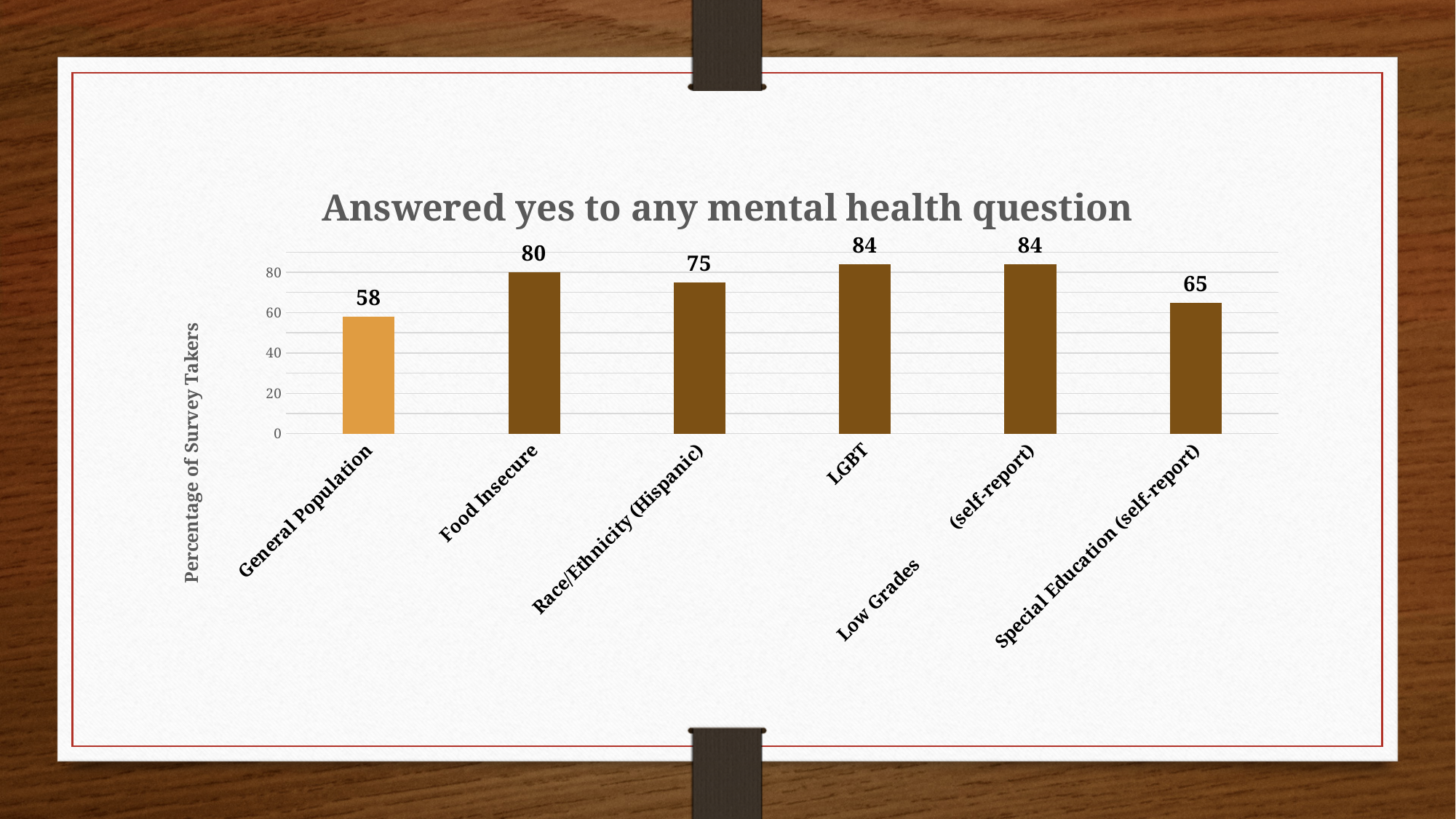
What is the title of the chart? Answered yes to any mental health question What kind of chart is shown on the slide? bar chart What is the difference between the values for LGBT and General Population? 26 What is the value for Food Insecure? 80 What is the value for Special Education (self-report)? 65 How many categories are shown in the chart? 6 Which is larger, the value for Food Insecure or the value for Race/Ethnicity (Hispanic)? Food Insecure What is the value for General Population? 58 What is the difference between the values for Food Insecure and Special Education (self-report)? 15 What is the value for Race/Ethnicity (Hispanic)? 75 What is the label of the vertical axis? Percentage of Survey Takers Which category has the lowest value? General Population